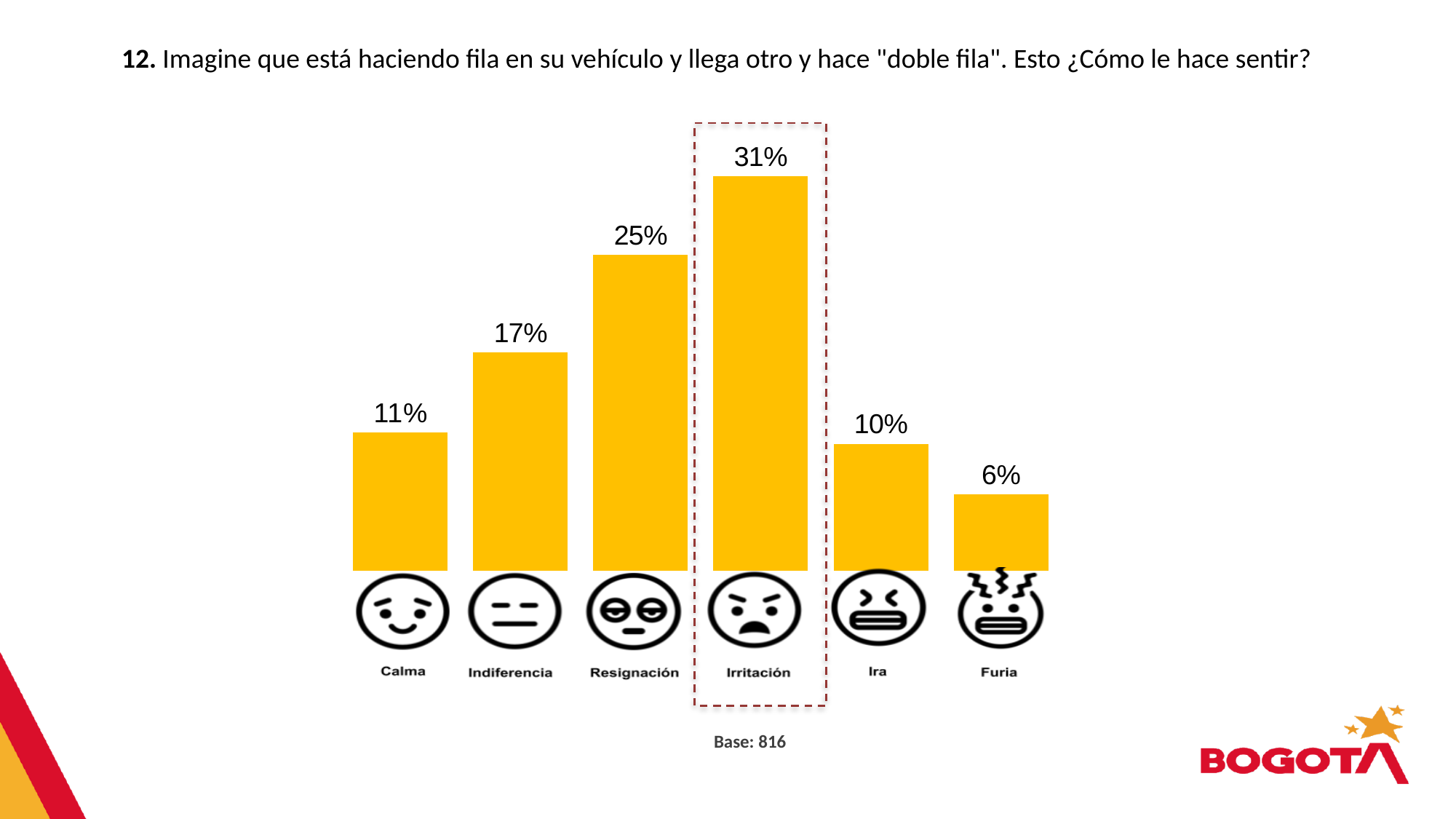
What is the value shown for Calma? 11% What is the difference between the values for Irritación and Resignación? 6% How many feeling categories are shown in the chart? 6 Which feeling has the lowest percentage? Furia Which feeling has the highest percentage? Irritación What kind of chart is shown on the slide? Bar chart What is the base (number of respondents) shown below the chart? 816 Which is larger, the value for Calma or the value for Ira? Calma What is the difference between the values for Indiferencia and Ira? 7% What is the value for Furia? 6% What percentage is shown for Resignación? 25% What percentage of respondents said they feel Irritación? 31%